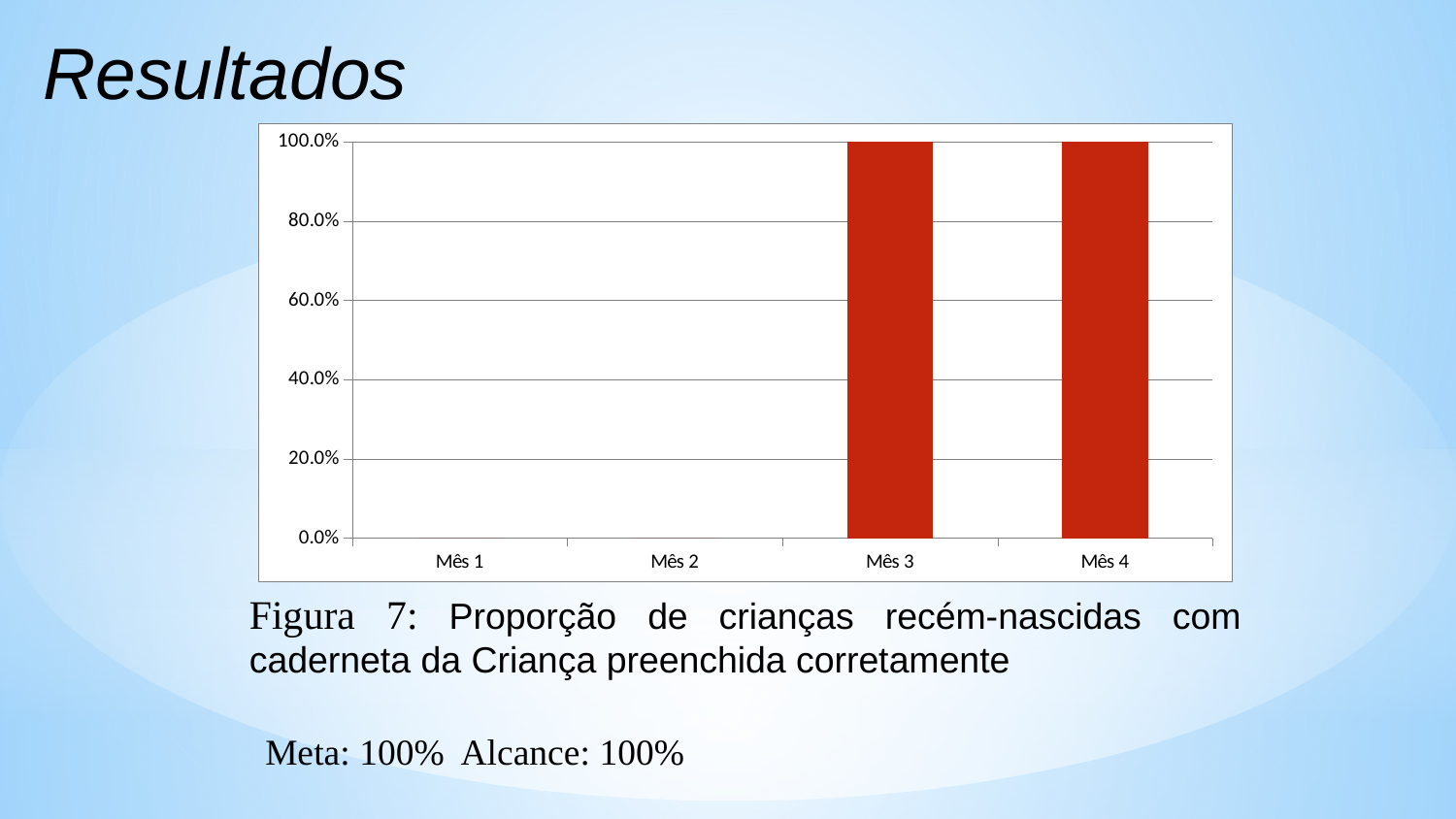
What is the highest value shown on the y axis of the chart? 100.0% What is the value for Mês 3? 100.0% Which is larger, the value for Mês 2 or the value for Mês 3? Mês 3 What is the value for Mês 1? 0.0% How many categories are shown on the x axis of the chart? 4 Is the value for Mês 1 greater or less than 20.0%? less What is the value for Mês 2? 0.0% What is the difference between the value for Mês 4 and the value for Mês 1? 100.0% Is the value for Mês 3 greater or less than 80.0%? greater Do the values rise or fall from Mês 2 to Mês 3? rise What kind of chart is shown on the slide? bar chart What is the value for Mês 4? 100.0%